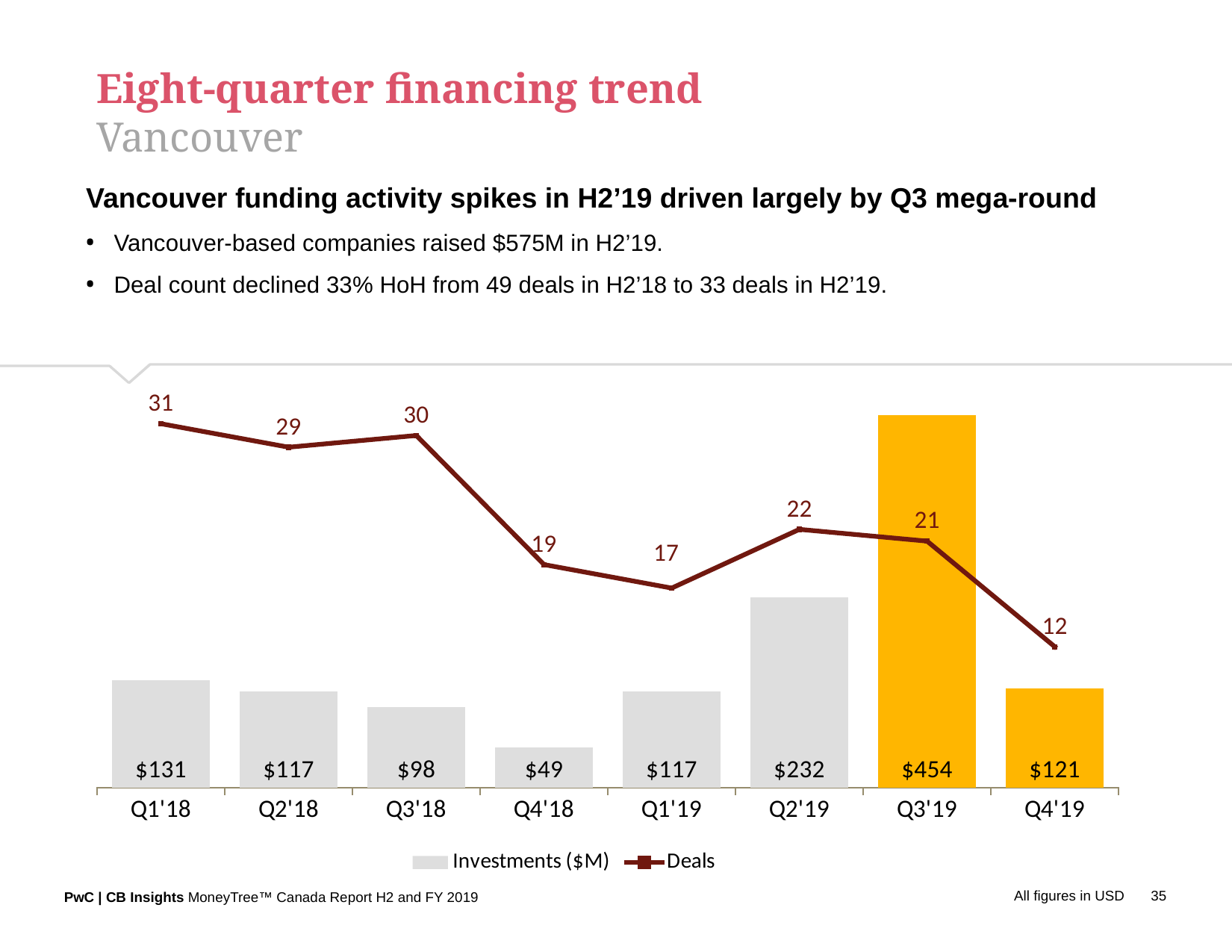
Which quarter has the lowest Investments ($M) value? Q4'18 What is the Investments ($M) value for Q3'19? $454 What is the difference in Deals between Q1'18 and Q4'19? 19 How many quarters are shown on the x axis? 8 How many series does the legend list? 2 Which quarter has the highest Investments ($M) value? Q3'19 What kind of chart is used to show Investments ($M)? Bar chart Which quarter has the lowest number of Deals? Q4'19 What is the difference in Investments ($M) between Q3'19 and Q2'19? $222 Which quarter had more Deals, Q2'19 or Q3'19? Q2'19 How many Deals were there in Q1'19? 17 Do the Deals values generally rise or fall from Q1'18 to Q4'19? Fall